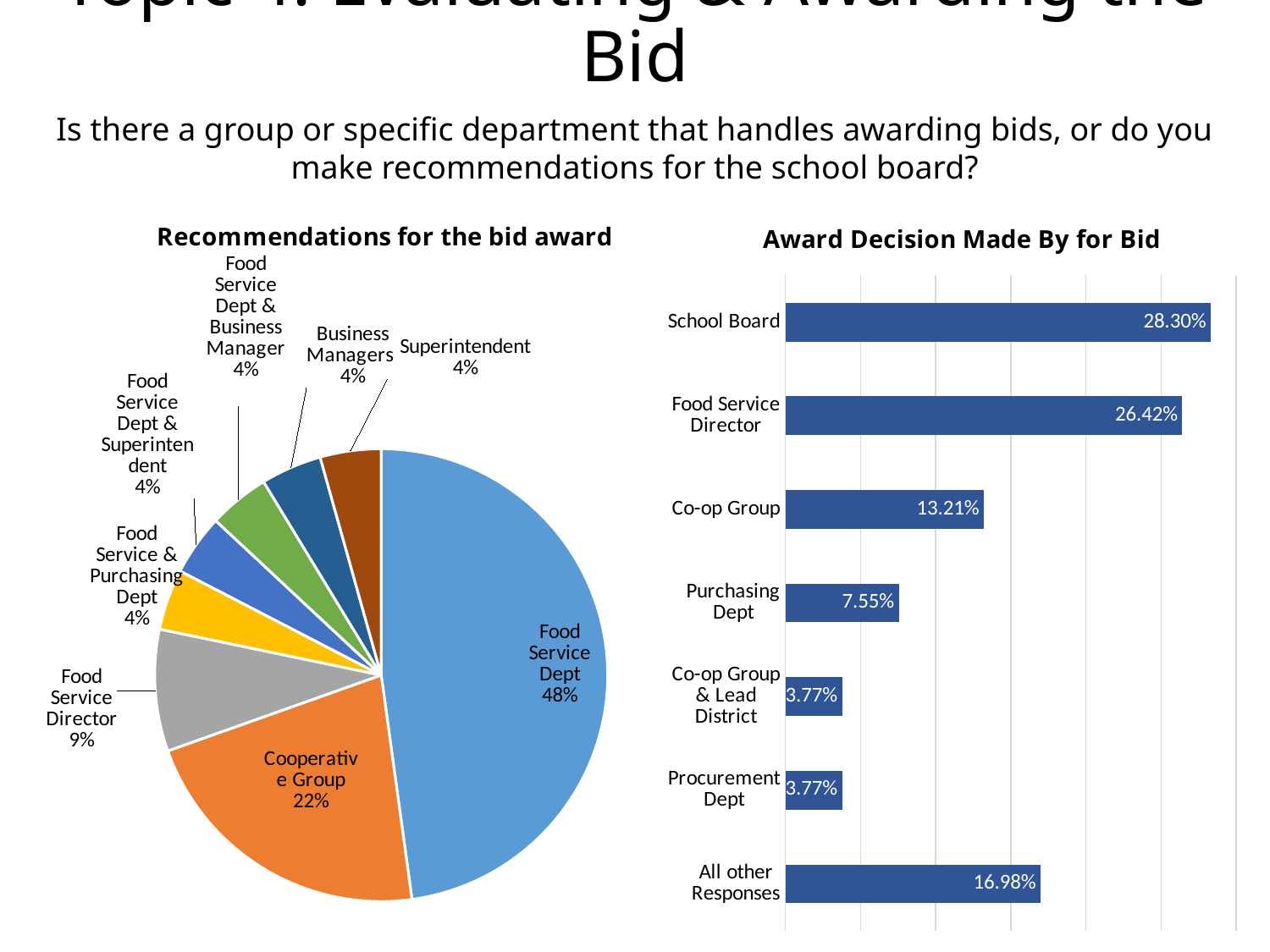
In the 'Recommendations for the bid award' pie chart, what share does Cooperative Group have? 22% What kind of chart is 'Award Decision Made By for Bid'? Bar chart In the 'Award Decision Made By for Bid' chart, what is the value for Co-op Group? 13.21% In the 'Award Decision Made By for Bid' chart, which category has the highest value? School Board In the 'Award Decision Made By for Bid' chart, what is the difference between School Board and Food Service Director? 1.88% In the 'Recommendations for the bid award' pie chart, what share does Food Service Dept have? 48% How many categories are shown in the 'Award Decision Made By for Bid' chart? 7 In the 'Award Decision Made By for Bid' chart, which is larger: Purchasing Dept or All other Responses? All other Responses In the 'Recommendations for the bid award' pie chart, which slice is the largest? Food Service Dept In the 'Award Decision Made By for Bid' chart, what is the value for School Board? 28.30% What kind of chart is 'Recommendations for the bid award'? Pie chart How many slices are in the 'Recommendations for the bid award' pie chart? 8